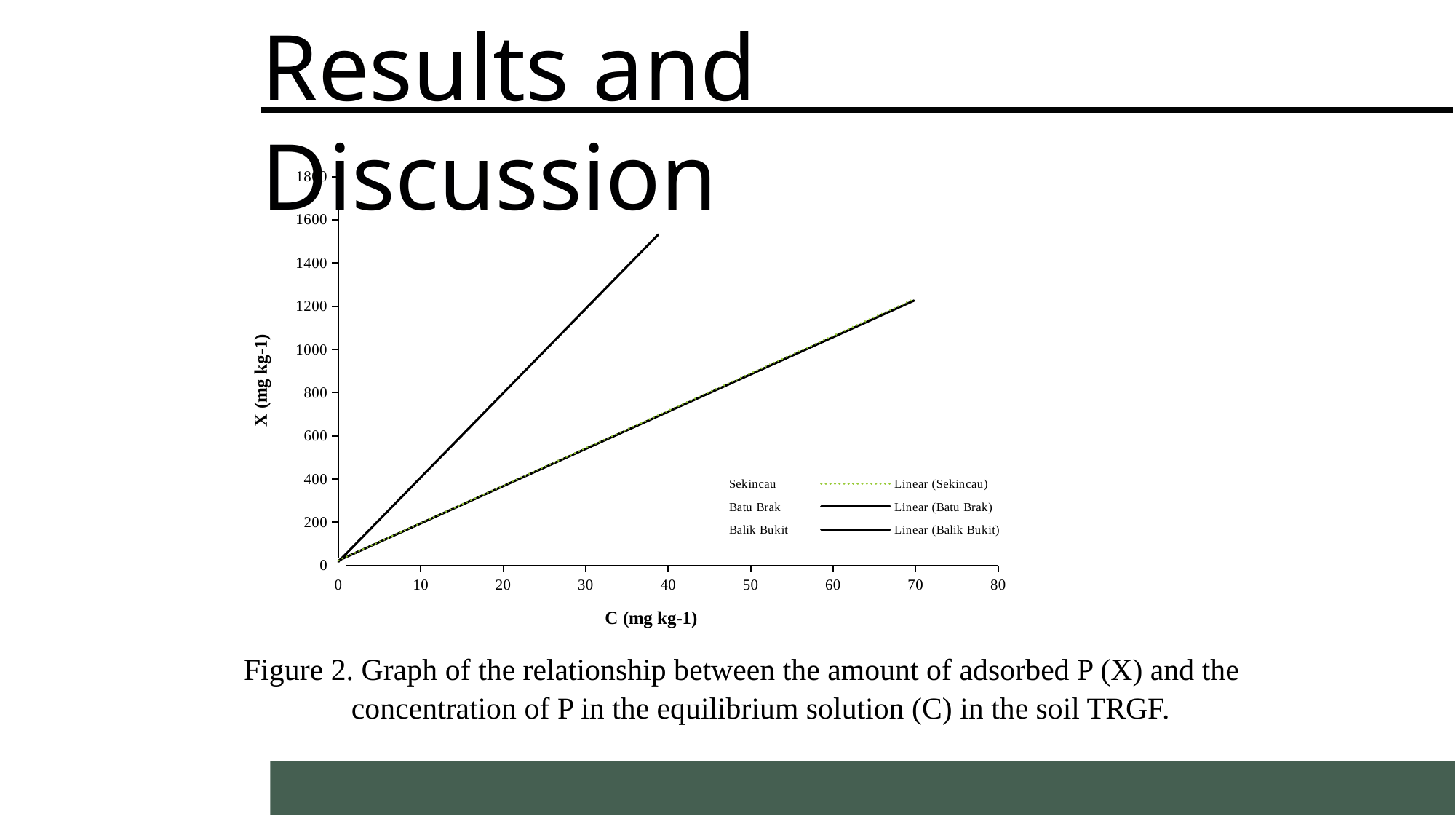
Do the plotted lines rise or fall as C increases along the x axis? rise Is the highest point reached by the steeper line greater or less than 1400? greater Is the highest point reached by the shallower line greater or less than 1000? greater Which three soil locations are named in the chart legend? Sekincau, Batu Brak, Balik Bukit Is the highest point reached by the shallower line greater or less than 1400? less What is the title of the vertical axis of the chart? X (mg kg-1) Which line reaches a higher X value, the steeper line or the shallower line? the steeper line How many entries does the chart legend list? 6 What kind of chart is shown on the slide? line chart